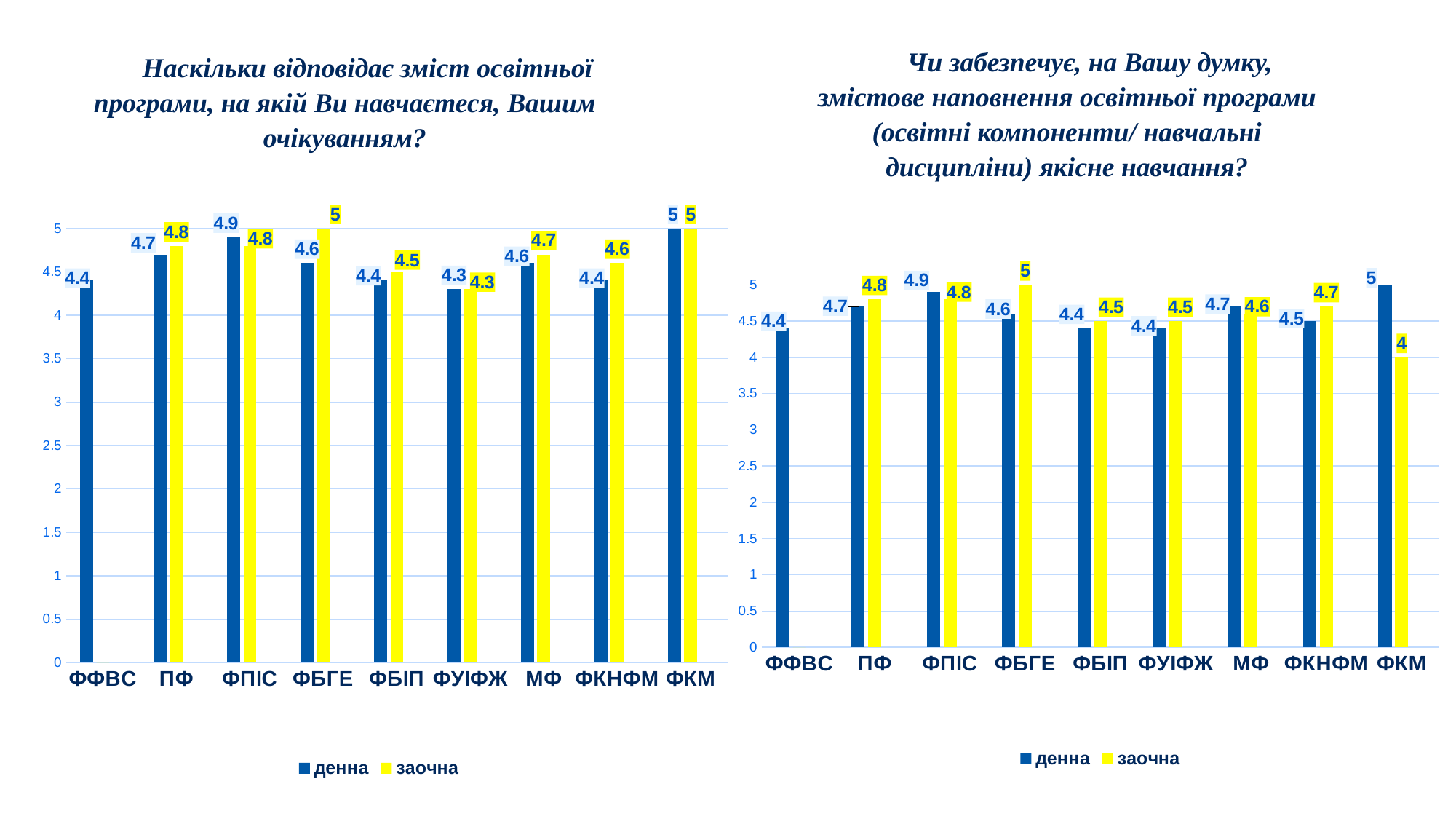
In the right chart, what is the value for денна at ФКНФМ? 4.5 In the left chart, what is the value for заочна at ФБГЕ? 5 How many series does the legend of the right chart list? 2 In the right chart, what is the value for заочна at ФКМ? 4 In the right chart, which is larger at МФ: денна or заочна? денна In the left chart, which category has the lowest денна value? ФУІФЖ In the left chart, which is larger at ФБГЕ: денна or заочна? заочна In the right chart, what is the difference between the денна and заочна values at ФКМ? 1 How many categories are shown on the x axis of the left chart? 9 What type of chart is the left chart? bar chart In the left chart, what is the value for денна at ФПІС? 4.9